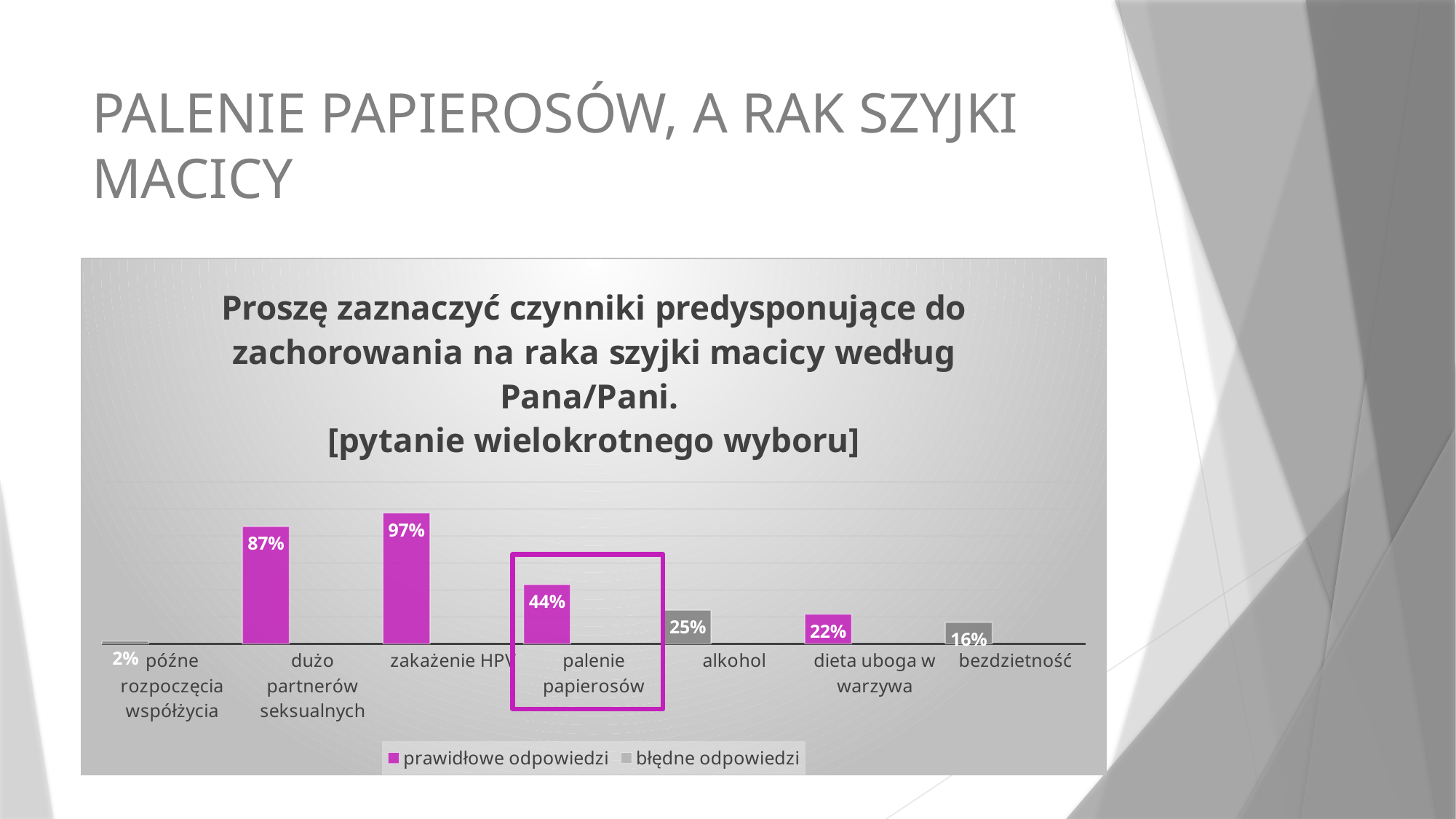
How many categories are shown on the x axis? 7 Which category has the highest value? zakażenie HPV Which is larger, the value for "alkohol" or the value for "dieta uboga w warzywa"? alkohol What is the value shown for "bezdzietność"? 16% What kind of chart is shown on the slide? bar chart Which legend entry is shown in magenta? prawidłowe odpowiedzi What is the value shown for "palenie papierosów"? 44% What is the value shown for "zakażenie HPV"? 97% What is the difference between the values for "zakażenie HPV" and "dużo partnerów seksualnych"? 10% How many series does the legend list? 2 Which category has the lowest value? późne rozpoczęcia współżycia What is the value shown for "alkohol"? 25%